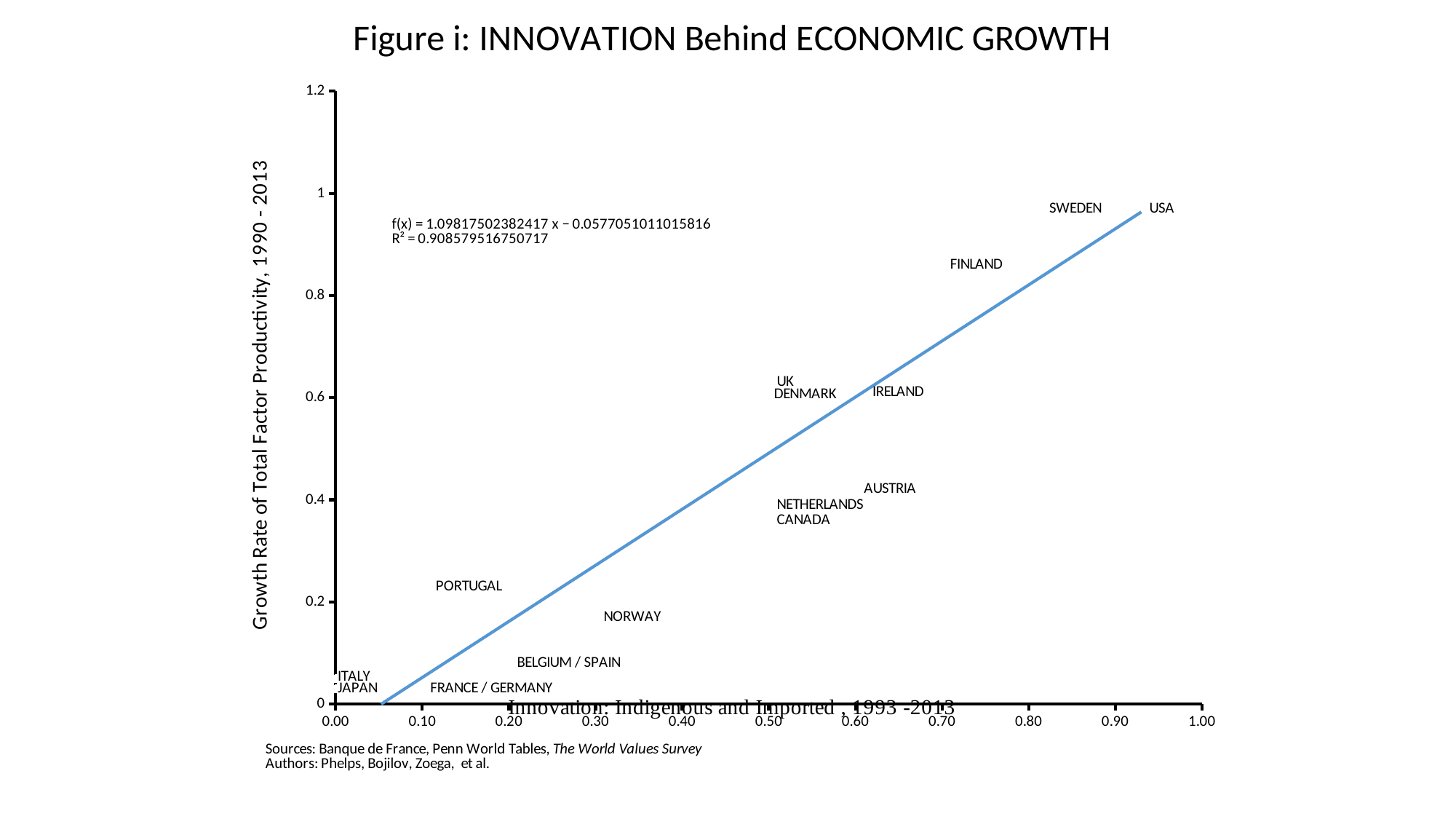
Is the growth rate of total factor productivity for SWEDEN greater or less than 0.8? greater What kind of chart is shown on the slide? scatter chart What R² value is printed for the trend line on the chart? 0.908579516750717 Is the growth rate of total factor productivity for FINLAND greater or less than 0.6? greater Which has a higher growth rate of total factor productivity, FINLAND or NORWAY? FINLAND Is the growth rate of total factor productivity for USA greater or less than 0.8? greater What is the title of the chart? Figure i: INNOVATION Behind ECONOMIC GROWTH Which has a higher growth rate of total factor productivity, USA or PORTUGAL? USA Does the trend line rise or fall as innovation increases along the x axis? rises